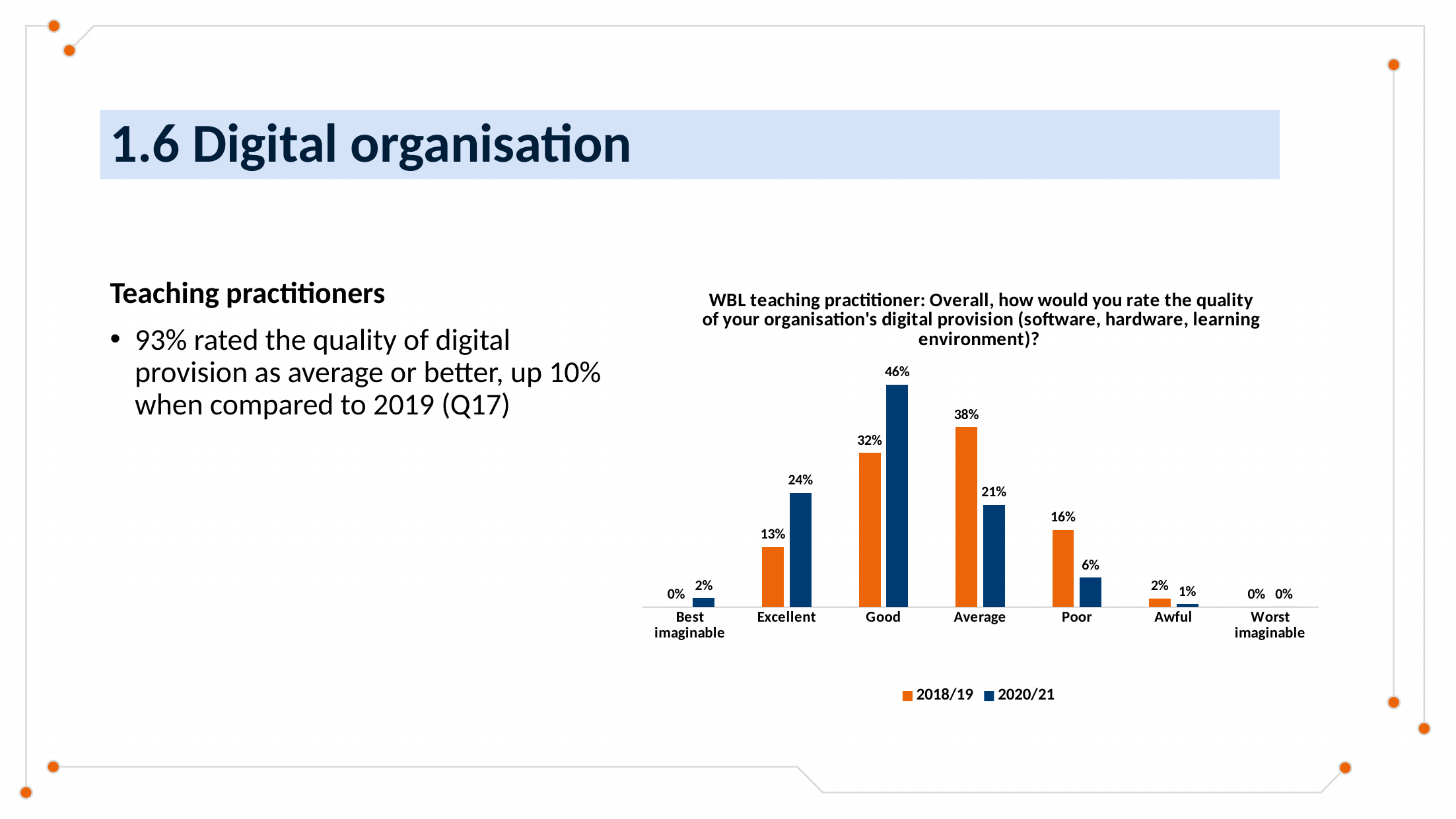
What is the difference between the 2020/21 and 2018/19 values for Good? 14% How many categories are shown on the x axis? 7 Which category has the highest value in the 2018/19 series? Average What is the value for Good in the 2020/21 series? 46% What is the value for Poor in the 2018/19 series? 16% What kind of chart is shown on the slide? Bar chart What is the value for Average in the 2018/19 series? 38% What is the difference between the 2018/19 and 2020/21 values for Poor? 10% Which is larger for Average: the 2018/19 value or the 2020/21 value? 2018/19 What is the value for Excellent in the 2020/21 series? 24% How many series does the legend list? 2 Which category has the highest value in the 2020/21 series? Good